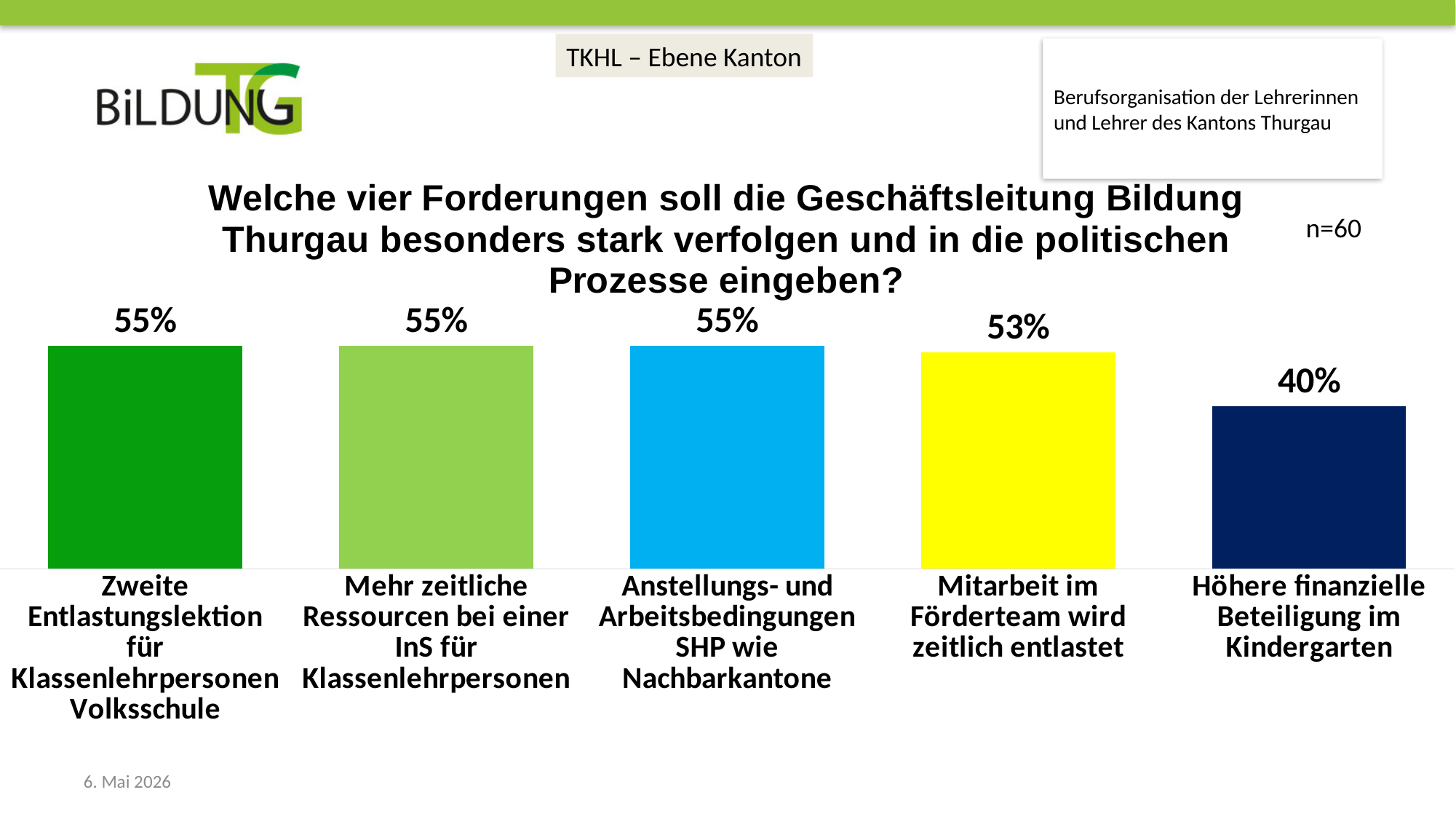
What kind of chart is shown on the slide? Bar chart What is the difference between the values for "Mitarbeit im Förderteam wird zeitlich entlastet" and "Höhere finanzielle Beteiligung im Kindergarten"? 13% How many categories share the highest value of 55%? 3 Which is larger: the value for "Mitarbeit im Förderteam wird zeitlich entlastet" or the value for "Höhere finanzielle Beteiligung im Kindergarten"? Mitarbeit im Förderteam wird zeitlich entlastet What is the sample size (n) stated on the slide? n=60 What is the value for "Zweite Entlastungslektion für Klassenlehrpersonen Volksschule"? 55% How many categories are shown in the chart? 5 What is the difference between the values for "Mehr zeitliche Ressourcen bei einer InS für Klassenlehrpersonen" and "Mitarbeit im Förderteam wird zeitlich entlastet"? 2% What is the value for "Mitarbeit im Förderteam wird zeitlich entlastet"? 53% What is the value for "Anstellungs- und Arbeitsbedingungen SHP wie Nachbarkantone"? 55% What is the value for "Höhere finanzielle Beteiligung im Kindergarten"? 40% Which category has the lowest value? Höhere finanzielle Beteiligung im Kindergarten